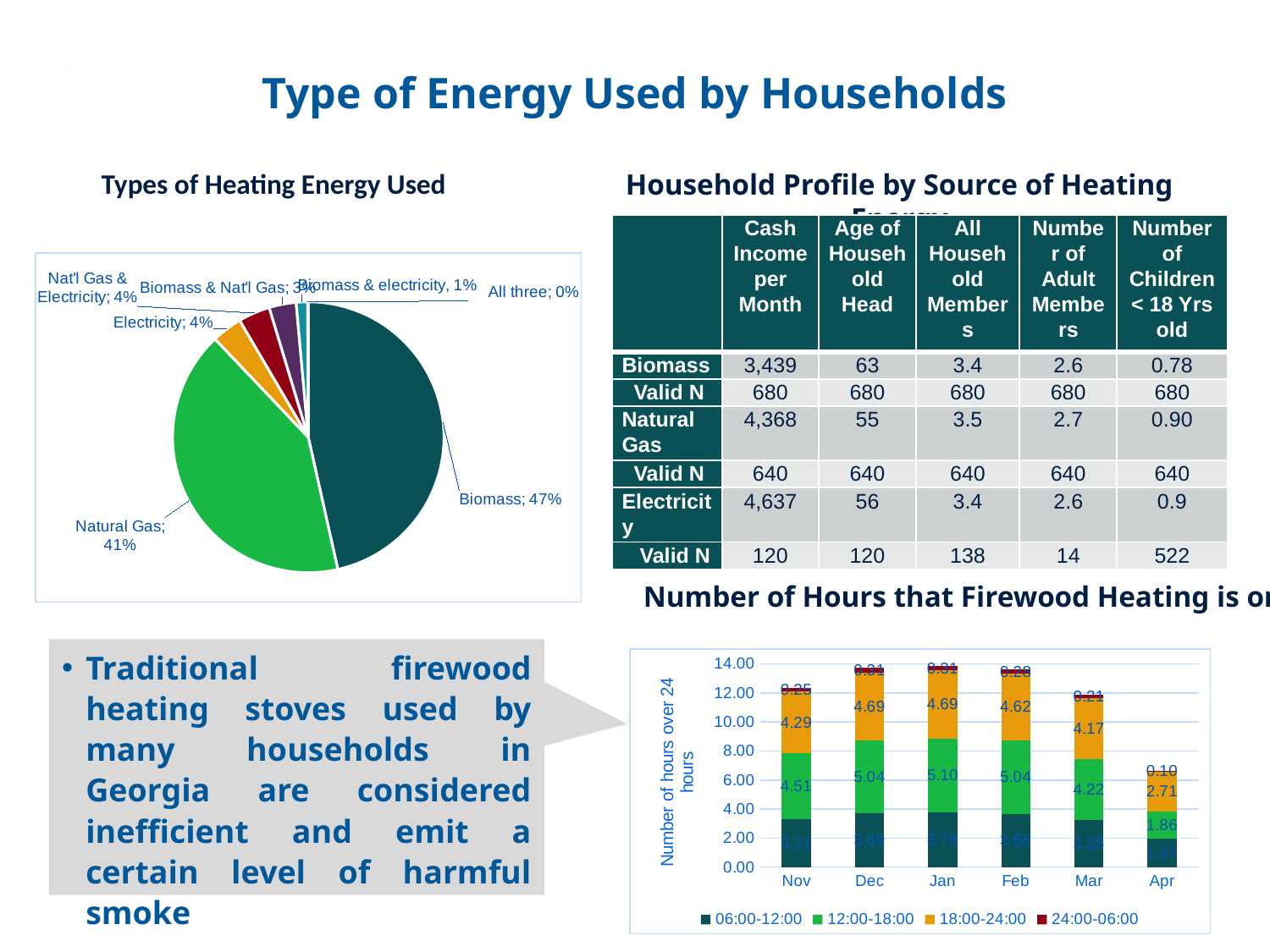
In the 'Types of Heating Energy Used' pie chart, what is the share for Biomass & Nat'l Gas? 3% What type of chart is the 'Types of Heating Energy Used' chart? pie chart In the 'Types of Heating Energy Used' pie chart, how many categories are shown? 7 In the 'Number of Hours that Firewood Heating is on' chart, what is the 18:00-24:00 value for Apr? 2.71 What type of chart is the 'Number of Hours that Firewood Heating is on' chart? stacked bar chart In the 'Number of Hours that Firewood Heating is on' chart, is the total for Apr greater or less than 8.00? less In the 'Number of Hours that Firewood Heating is on' chart, what is the 12:00-18:00 value for Jan? 5.10 In the 'Number of Hours that Firewood Heating is on' chart, how many series does the legend list? 4 In the 'Types of Heating Energy Used' pie chart, what share is Biomass? 47% In the 'Types of Heating Energy Used' pie chart, which category has the largest share? Biomass In the 'Types of Heating Energy Used' pie chart, what share is Natural Gas? 41% In the 'Number of Hours that Firewood Heating is on' chart, what is the difference between the 12:00-18:00 values for Dec and Mar? 0.82